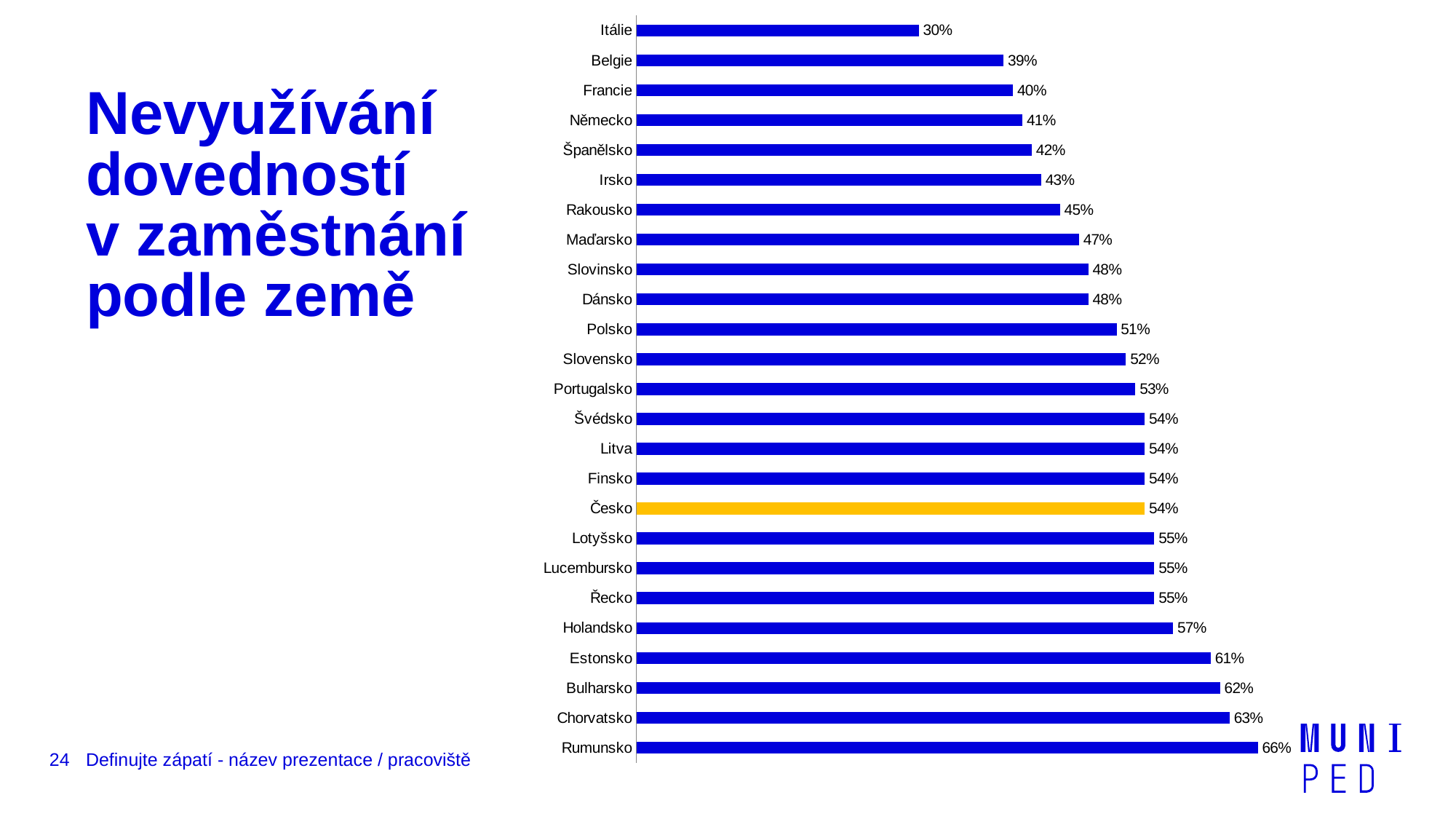
Which has a larger value, Belgie or Chorvatsko? Chorvatsko Which country's bar is highlighted in a different colour (yellow) from the others? Česko Which has a larger value, Rakousko or Maďarsko? Maďarsko Which country has the highest value? Rumunsko What is the value for Itálie? 30% How many countries are shown in the chart? 25 What is the difference between the values for Rumunsko and Itálie? 36% Which country has the lowest value? Itálie What is the value for Česko? 54% What kind of chart is shown on the slide? Bar chart What is the value for Holandsko? 57% What is the difference between the values for Estonsko and Polsko? 10%